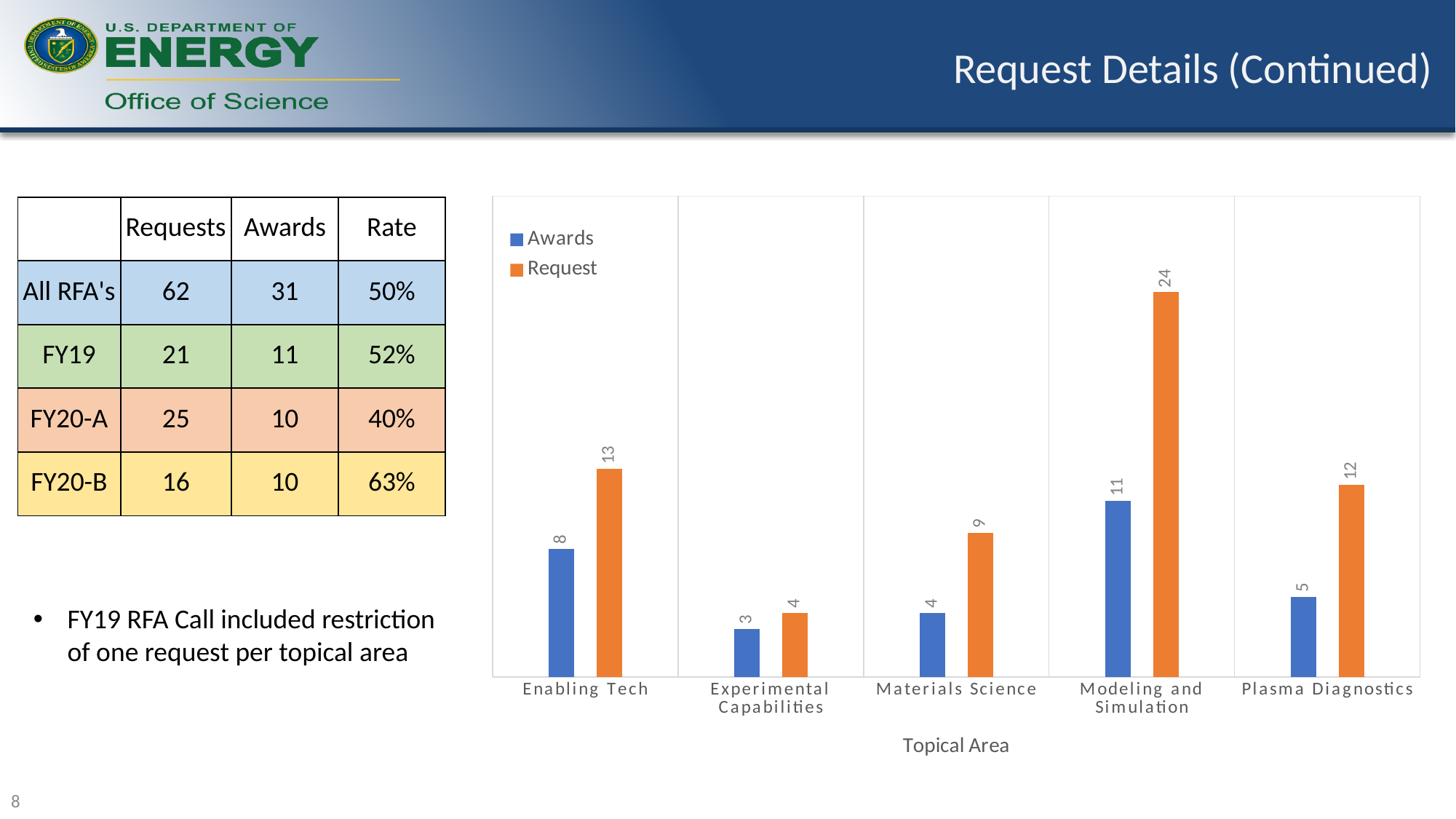
Which is larger, the Awards value for Materials Science or the Awards value for Plasma Diagnostics? Plasma Diagnostics What is the difference between the Request values for Enabling Tech and Plasma Diagnostics? 1 What is the Request value for Modeling and Simulation? 24 What is the difference between the Request and Awards values for Modeling and Simulation? 13 Which topical area has the highest Request value? Modeling and Simulation What kind of chart is shown on the slide? Bar chart What is the Awards value for Plasma Diagnostics? 5 How many topical areas are shown on the x axis of the chart? 5 Which topical area has the lowest Awards value? Experimental Capabilities What is the x-axis title of the chart? Topical Area What is the Awards value for Enabling Tech? 8 How many series does the chart legend list? 2